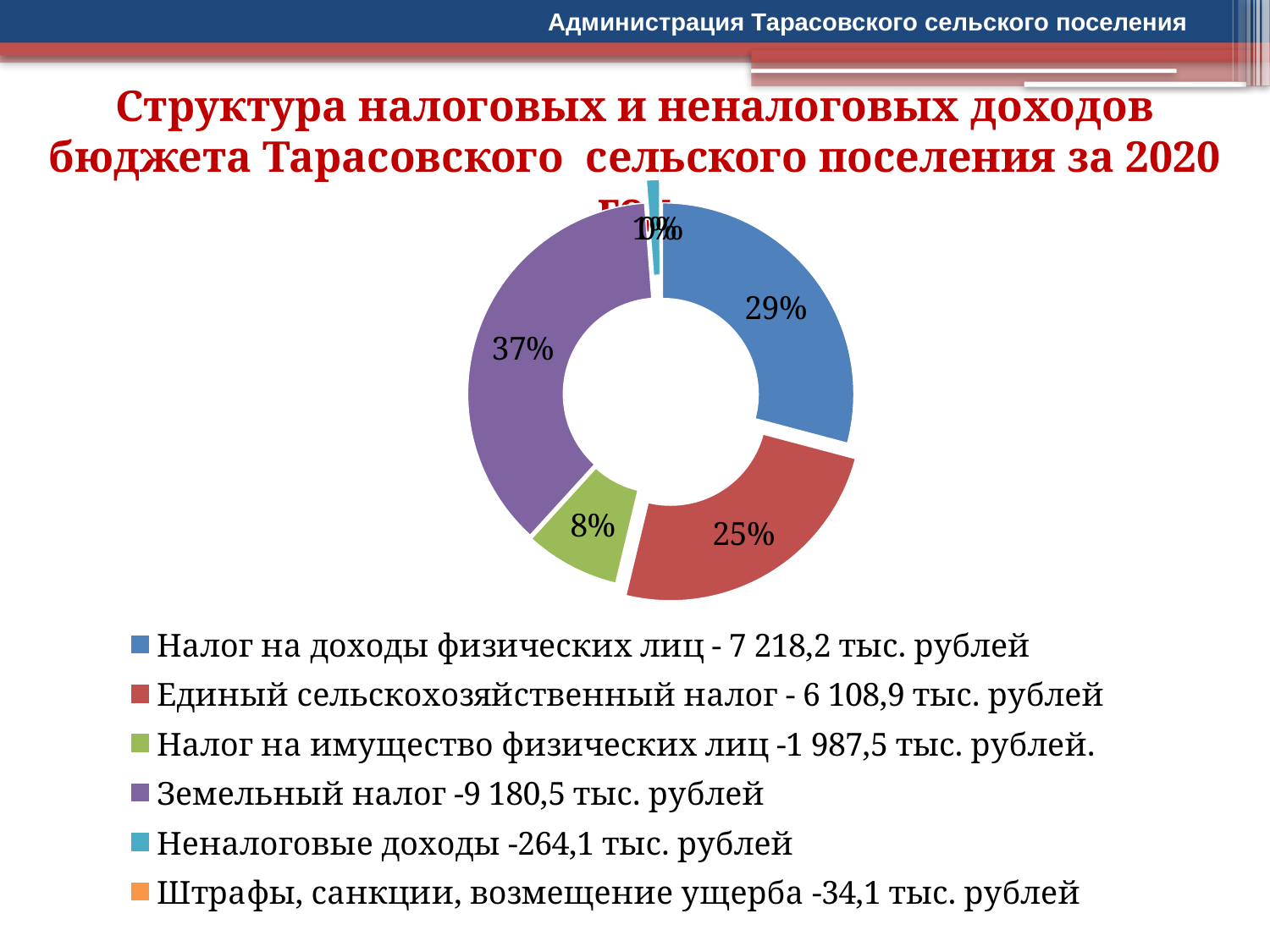
What is the difference in percentage points between the share for Земельный налог and the share for Налог на имущество физических лиц? 29 What percentage is shown for Налог на имущество физических лиц? 8% What kind of chart is shown on the slide? Doughnut (pie) chart Which is larger: the share for Налог на доходы физических лиц or the share for Единый сельскохозяйственный налог? Налог на доходы физических лиц What share of the chart does Налог на доходы физических лиц account for? 29% How many categories does the legend list? 6 According to the legend, what amount is given for Земельный налог? 9 180,5 тыс. рублей What percentage is shown for Единый сельскохозяйственный налог? 25% What share of the chart does Земельный налог account for? 37% According to the legend, what amount is given for Неналоговые доходы? 264,1 тыс. рублей Which category has the largest share of the chart? Земельный налог What colour represents Единый сельскохозяйственный налог in the chart? Red